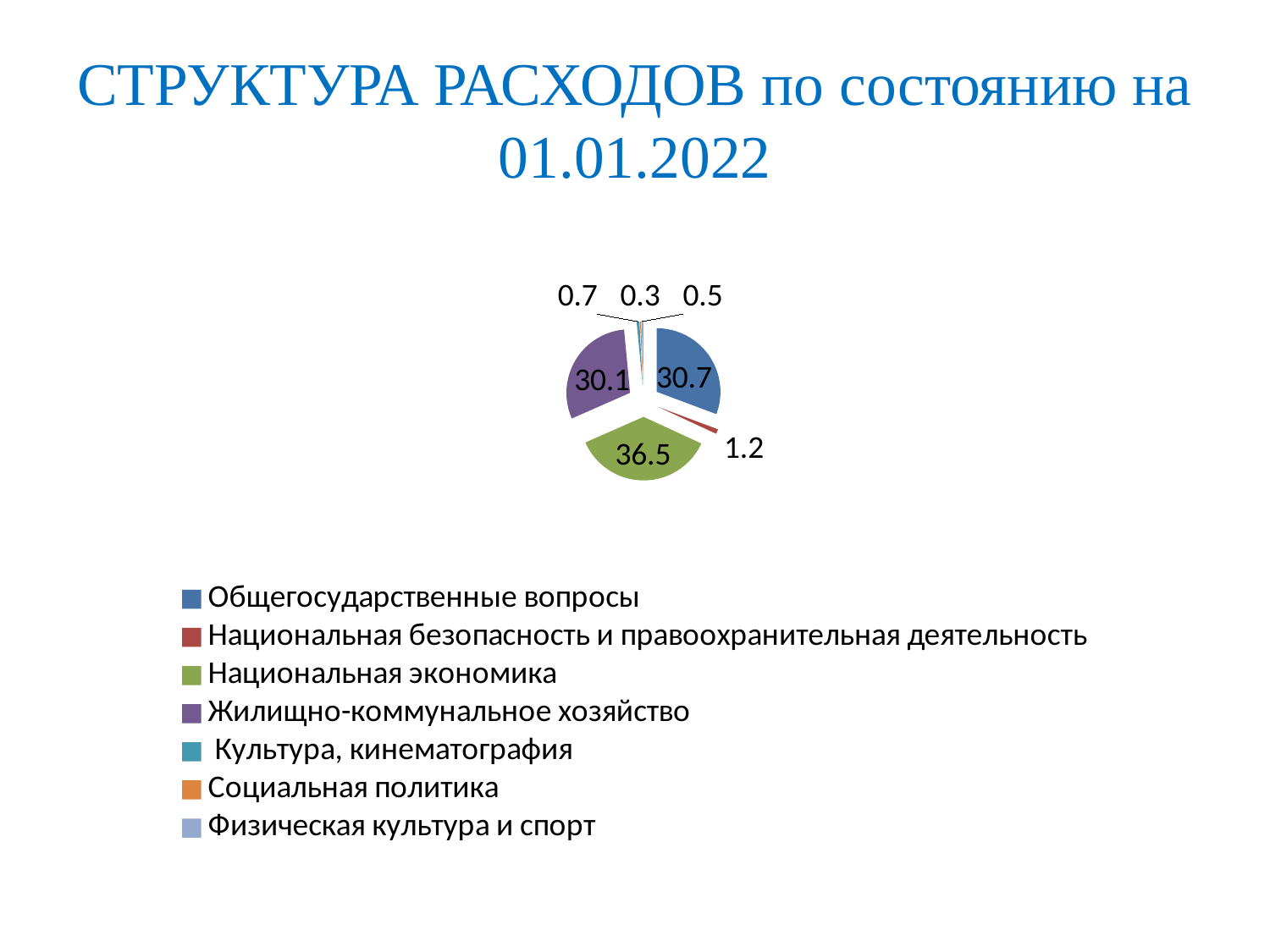
What is the difference between the values for Национальная экономика and Общегосударственные вопросы? 5.8 What is the difference between the values for Общегосударственные вопросы and Жилищно-коммунальное хозяйство? 0.6 What is the value for Национальная безопасность и правоохранительная деятельность? 1.2 Which category has the largest slice of the pie? Национальная экономика Which is larger, the value for Национальная экономика or the value for Жилищно-коммунальное хозяйство? Национальная экономика What is the value for Общегосударственные вопросы? 30.7 What is the value for Жилищно-коммунальное хозяйство? 30.1 What kind of chart is shown on the slide? pie chart How many categories does the legend list? 7 What is the title of the slide? СТРУКТУРА РАСХОДОВ по состоянию на 01.01.2022 What is the value for Национальная экономика? 36.5 What is the smallest value labelled on the pie chart? 0.3